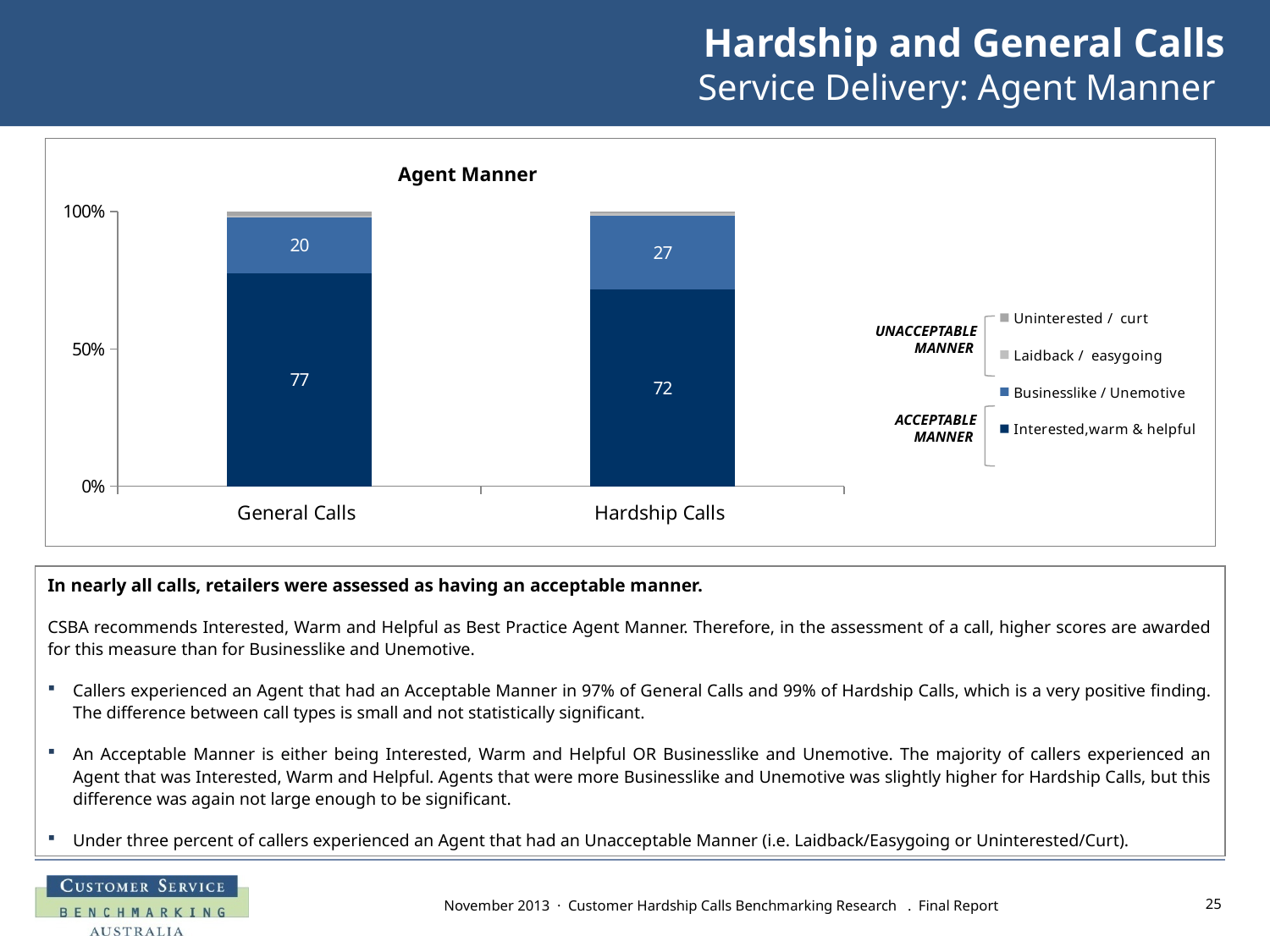
How many call type categories are shown on the x axis? 2 What kind of chart is shown on the slide? Stacked bar chart Which call type has the lower value for Businesslike / Unemotive? General Calls Which call type has the higher value for Interested, warm & helpful? General Calls Is the Businesslike / Unemotive value larger for General Calls or Hardship Calls? Hardship Calls How many series does the legend list? 4 What is the value for Interested, warm & helpful in General Calls? 77 What is the value for Businesslike / Unemotive in Hardship Calls? 27 What is the value for Interested, warm & helpful in Hardship Calls? 72 What is the value for Businesslike / Unemotive in General Calls? 20 What is the difference between the Interested, warm & helpful values for General Calls and Hardship Calls? 5 What is the difference between the Businesslike / Unemotive values for Hardship Calls and General Calls? 7